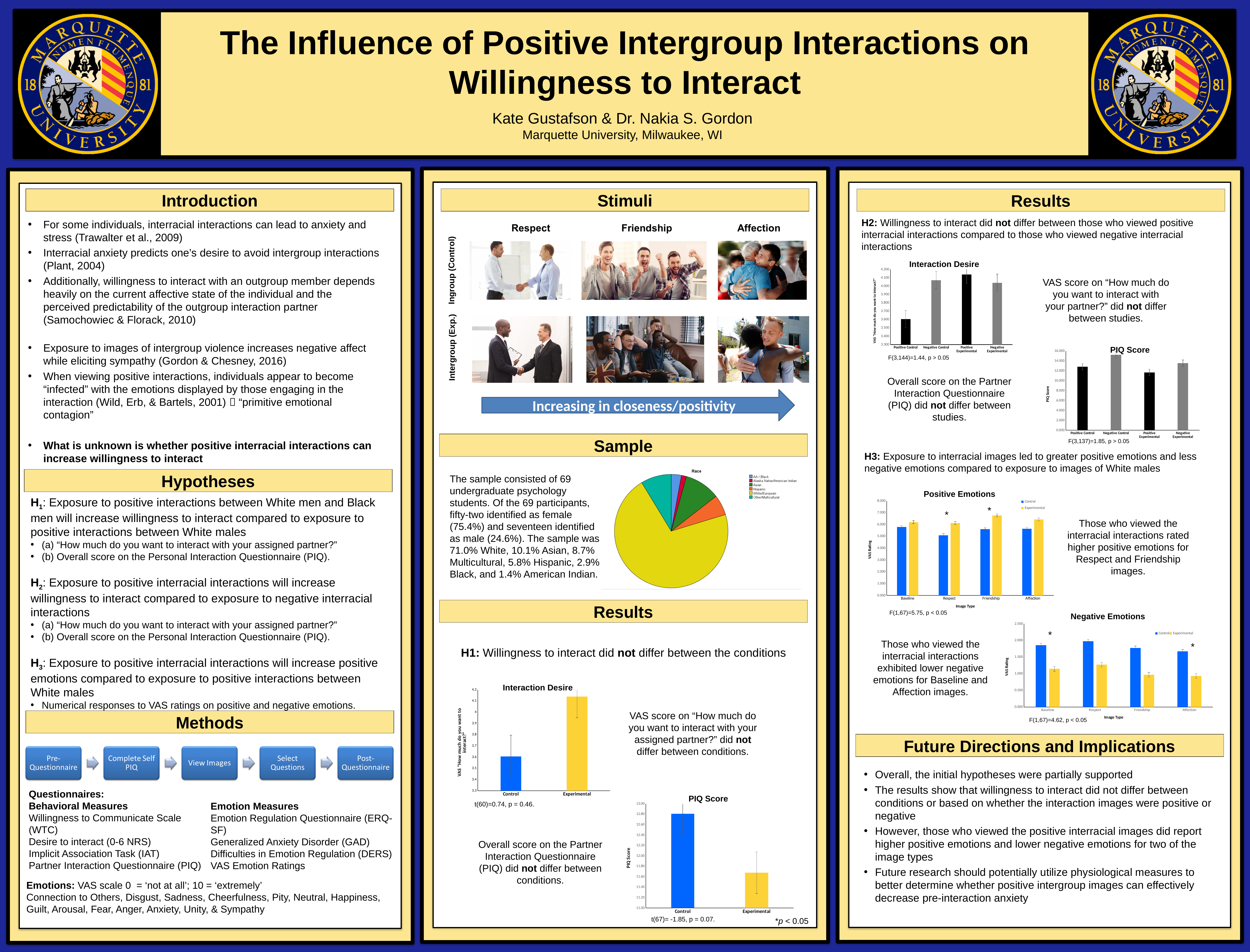
In the "Negative Emotions" chart, is the Control value for Respect greater or less than 1.500? greater In the "Interaction Desire" chart under H1 (middle column), which condition has the higher bar, Control or Experimental? Experimental How many series does the legend of the "Positive Emotions" chart list? 2 In the "Race" pie chart in the Sample section, which category has the largest slice? White/European In the "PIQ Score" chart under H2 (right column), which category has the highest bar? Negative Control What kind of chart is the "Race" chart in the Sample section? pie chart In the "Interaction Desire" chart under H1 (middle column), is the value for Control greater or less than 3.7? less In the "Positive Emotions" chart, for Respect, which series has the higher bar, Control or Experimental? Experimental In the "Interaction Desire" chart under H2 (right column), which category has the lowest bar? Positive Control In the "PIQ Score" chart under H2 (right column), is the value for Positive Experimental greater or less than 12.000? less How many categories does the legend of the "Race" pie chart list? 6